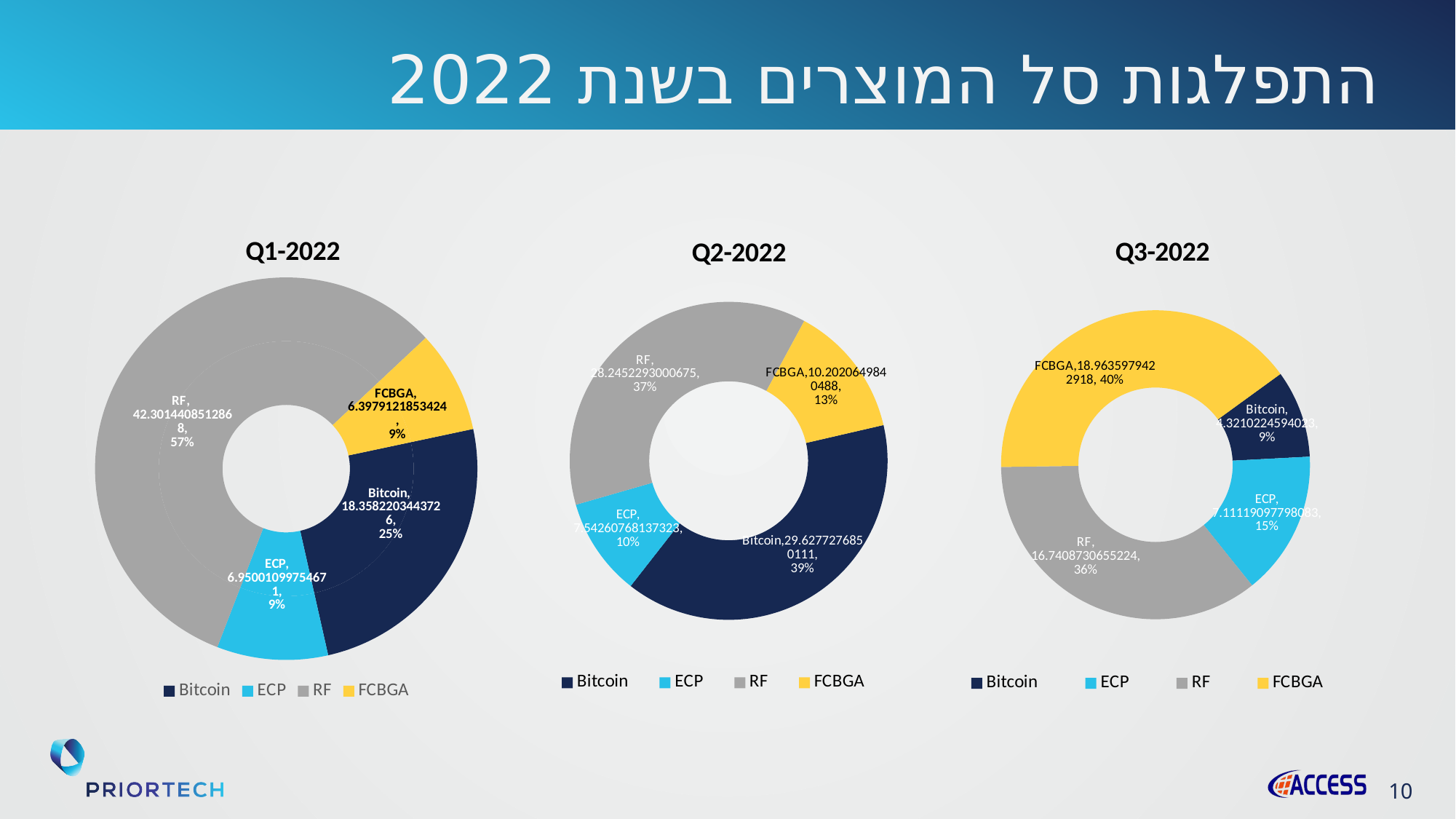
In the Q2-2022 chart, what percentage share does Bitcoin have? 39% In the Q1-2022 chart, what is the difference in percentage points between the RF share and the Bitcoin share? 32 What kind of chart is the Q2-2022 chart? Doughnut chart How many categories does the Q3-2022 chart show? 4 In the Q2-2022 chart, which category has the smallest share? ECP How many charts are shown on the slide? 3 In the Q2-2022 chart, which has the larger share, Bitcoin or FCBGA? Bitcoin In the Q3-2022 chart, what percentage share does FCBGA have? 40% In the Q3-2022 chart, which category has the smallest share? Bitcoin In the Q1-2022 chart, which category has the largest share? RF In the Q3-2022 chart, what percentage share does ECP have? 15% In the Q1-2022 chart, what percentage share does RF have? 57%